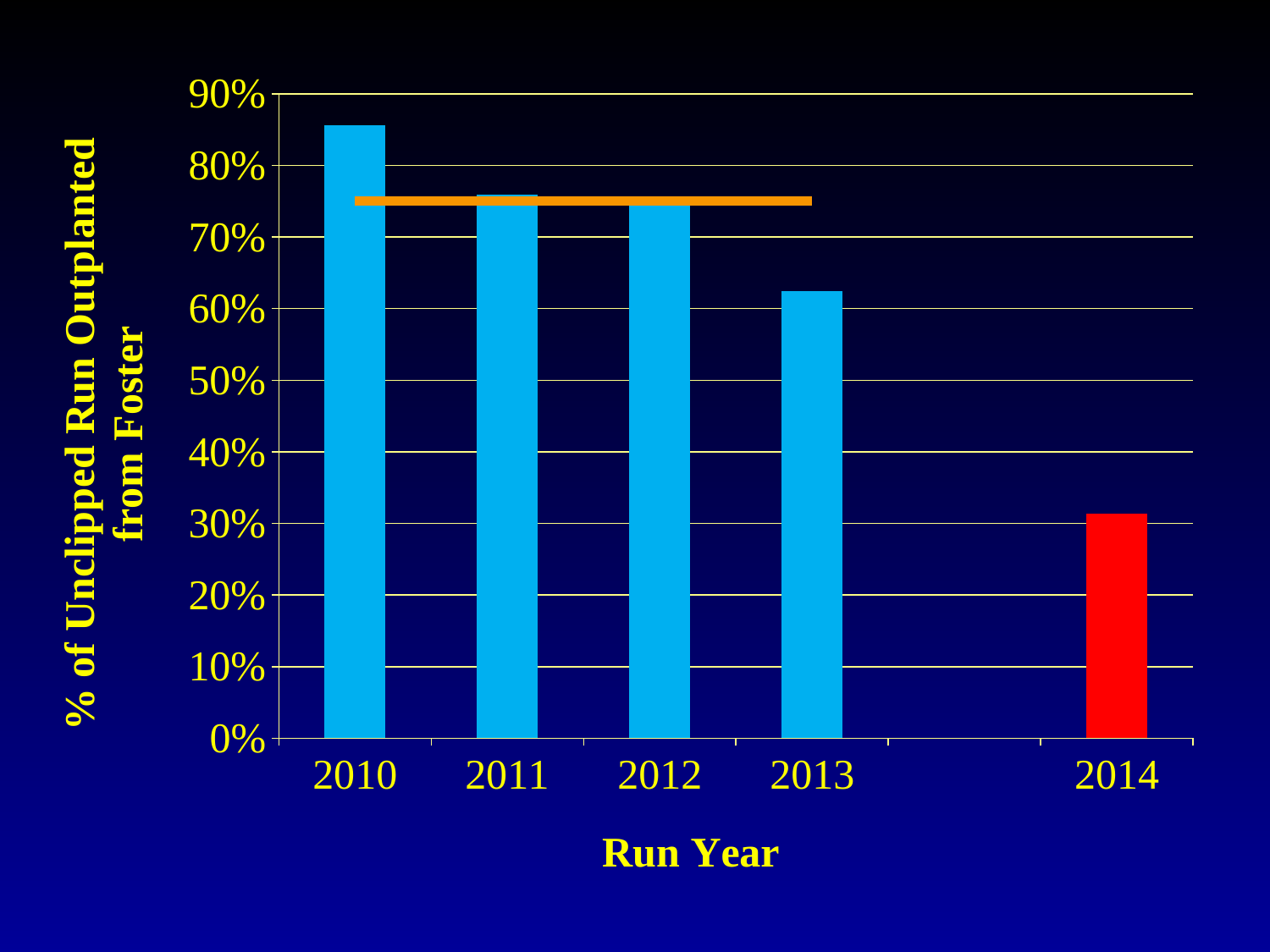
Which is larger, the value for 2013 or the value for 2014? 2013 Which is larger, the value for 2010 or the value for 2013? 2010 Is the value for 2011 greater or less than 70%? greater Is the value for 2014 greater or less than 40%? less Which run year has the lowest percentage of unclipped run outplanted from Foster? 2014 Which run year has the highest percentage of unclipped run outplanted from Foster? 2010 What is the label of the x axis? Run Year Is the value for 2013 greater or less than 70%? less What kind of chart is shown on the slide? bar chart How many run years are plotted on the chart? 5 Do the values rise or fall from 2010 to 2014? fall